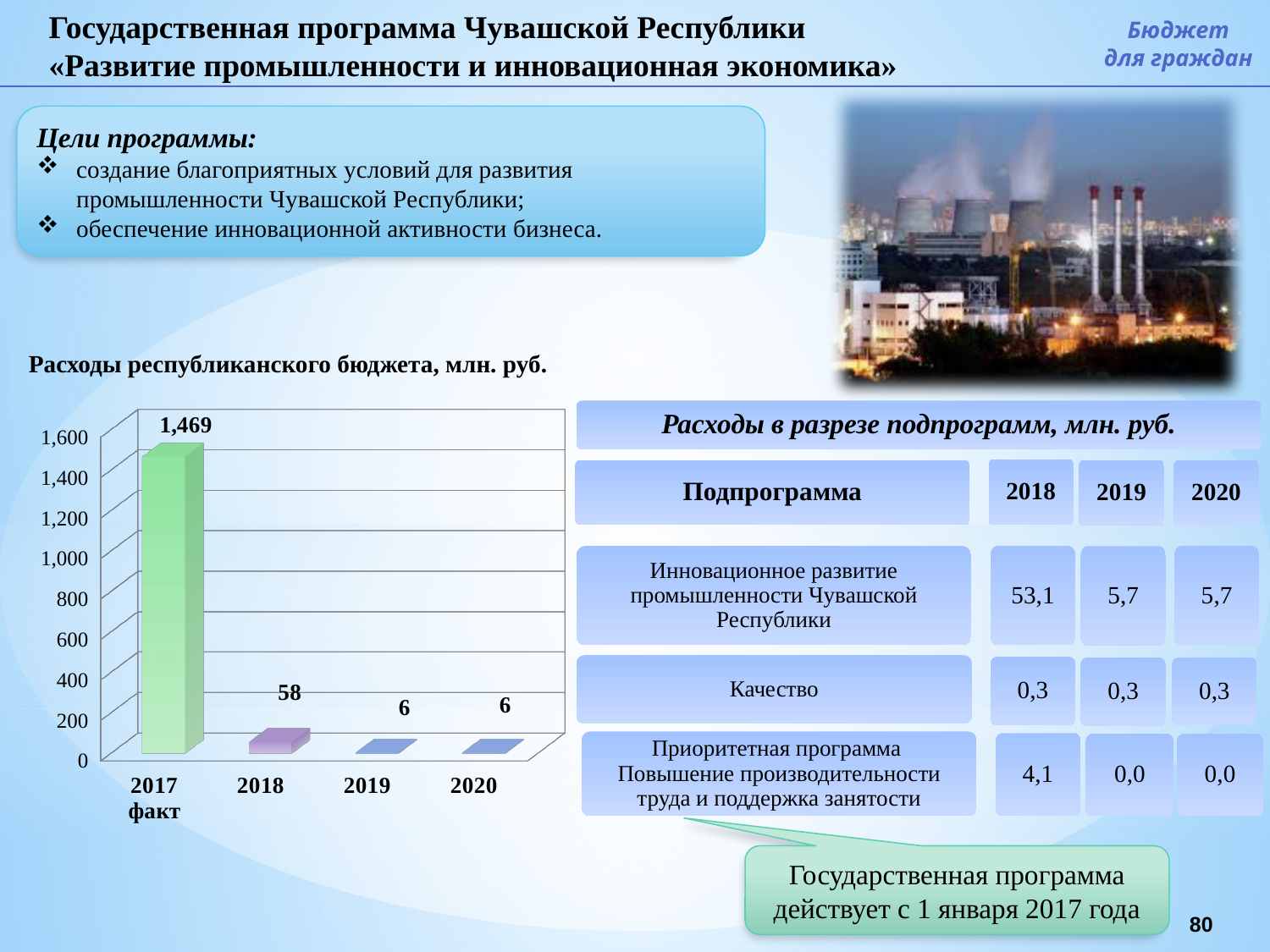
What is the value for 2017 факт in the chart? 1,469 What is the difference between the values for 2018 and 2019? 52 Which category has the highest value in the chart? 2017 факт What is the value for 2018 in the chart? 58 Is the value for 2017 факт greater or less than 1,400? greater Do the values rise or fall from 2017 факт to 2019 along the x axis? fall What is the value for 2020 in the chart? 6 What kind of chart is shown on the slide? bar chart Which is larger, the value for 2018 or the value for 2020? 2018 How many categories are shown on the x axis of the chart? 4 What is the difference between the values for 2017 факт and 2018? 1,411 What is the value for 2019 in the chart? 6